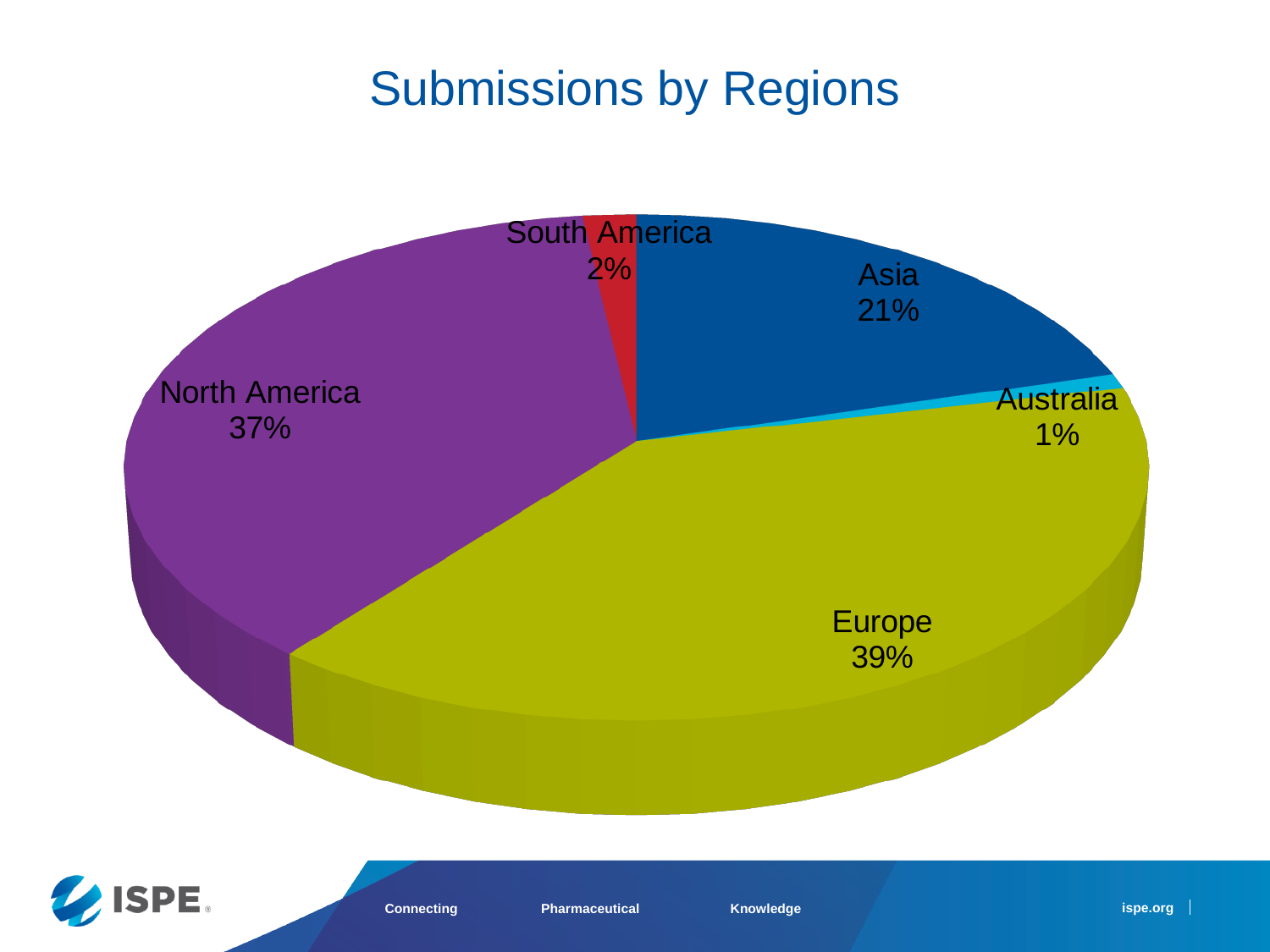
Which region has the smallest share of submissions? Australia Which has a larger share of submissions, Asia or North America? North America What share of submissions comes from Asia? 21% What share of submissions comes from Europe? 39% What share of submissions comes from South America? 2% What is the difference in percentage points between Europe's and Asia's shares? 18 Which region has the largest share of submissions? Europe What is the difference in percentage points between North America's and South America's shares? 35 What type of chart is shown on the slide? Pie chart How many regions are shown in the pie chart? 5